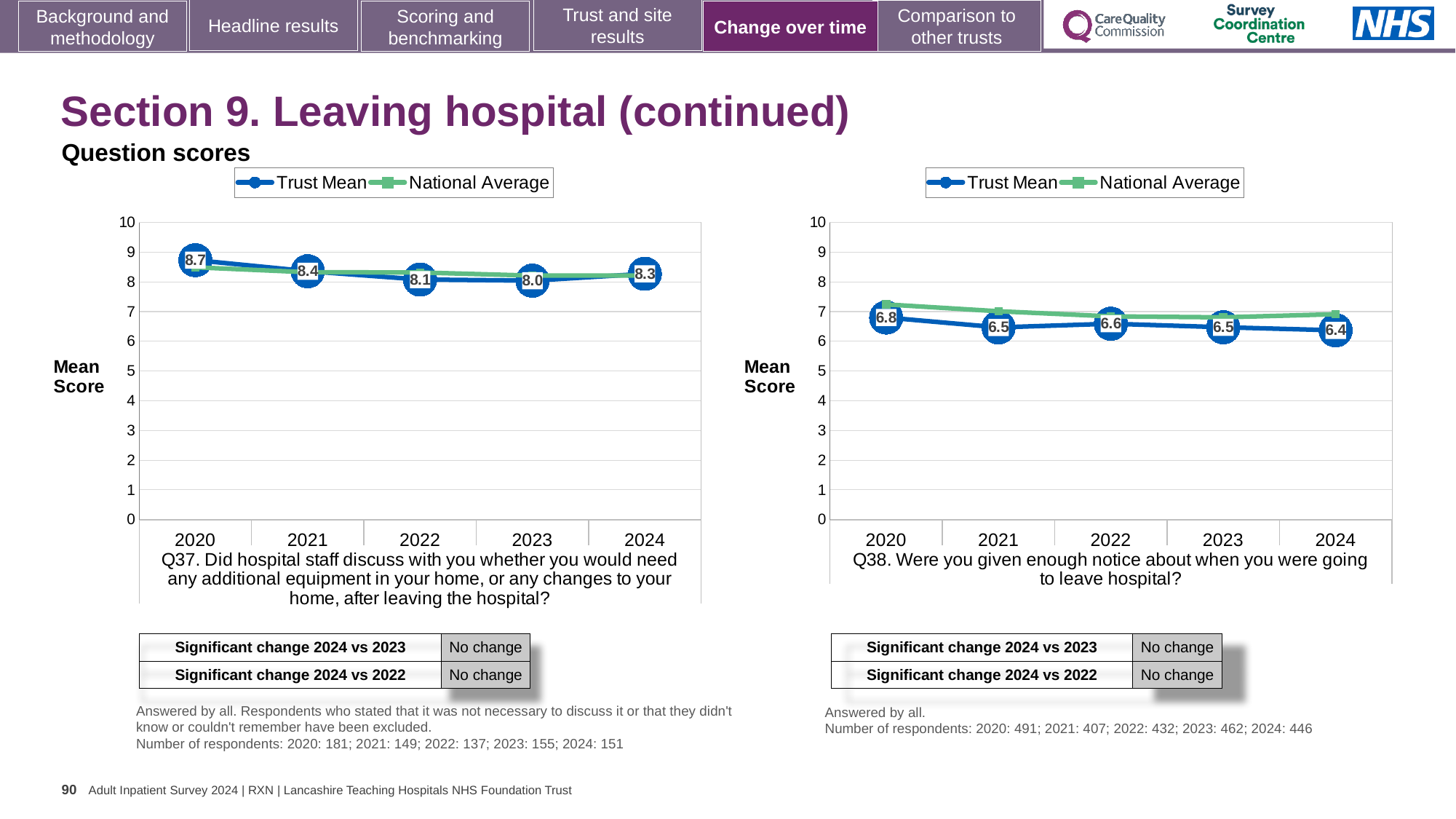
In the Q38 chart, is the Trust Mean score for 2021 greater or less than 7? less How many series does the legend of the Q38 chart list? 2 In the Q38 chart, what is the difference between the Trust Mean scores for 2020 and 2024? 0.4 In the Q37 chart, which year has the lowest Trust Mean score? 2023 In the Q38 chart, what is the Trust Mean score for 2022? 6.6 In the Q37 chart, what is the difference between the Trust Mean scores for 2020 and 2023? 0.7 In the Q37 chart, which year has the highest Trust Mean score? 2020 In the Q38 chart, which year has the highest Trust Mean score? 2020 How many years are plotted on the x axis of the Q37 chart? 5 In the Q37 chart, what is the Trust Mean score for 2020? 8.7 In the Q37 chart, what is the Trust Mean score for 2023? 8.0 In the Q38 chart, what is the Trust Mean score for 2024? 6.4